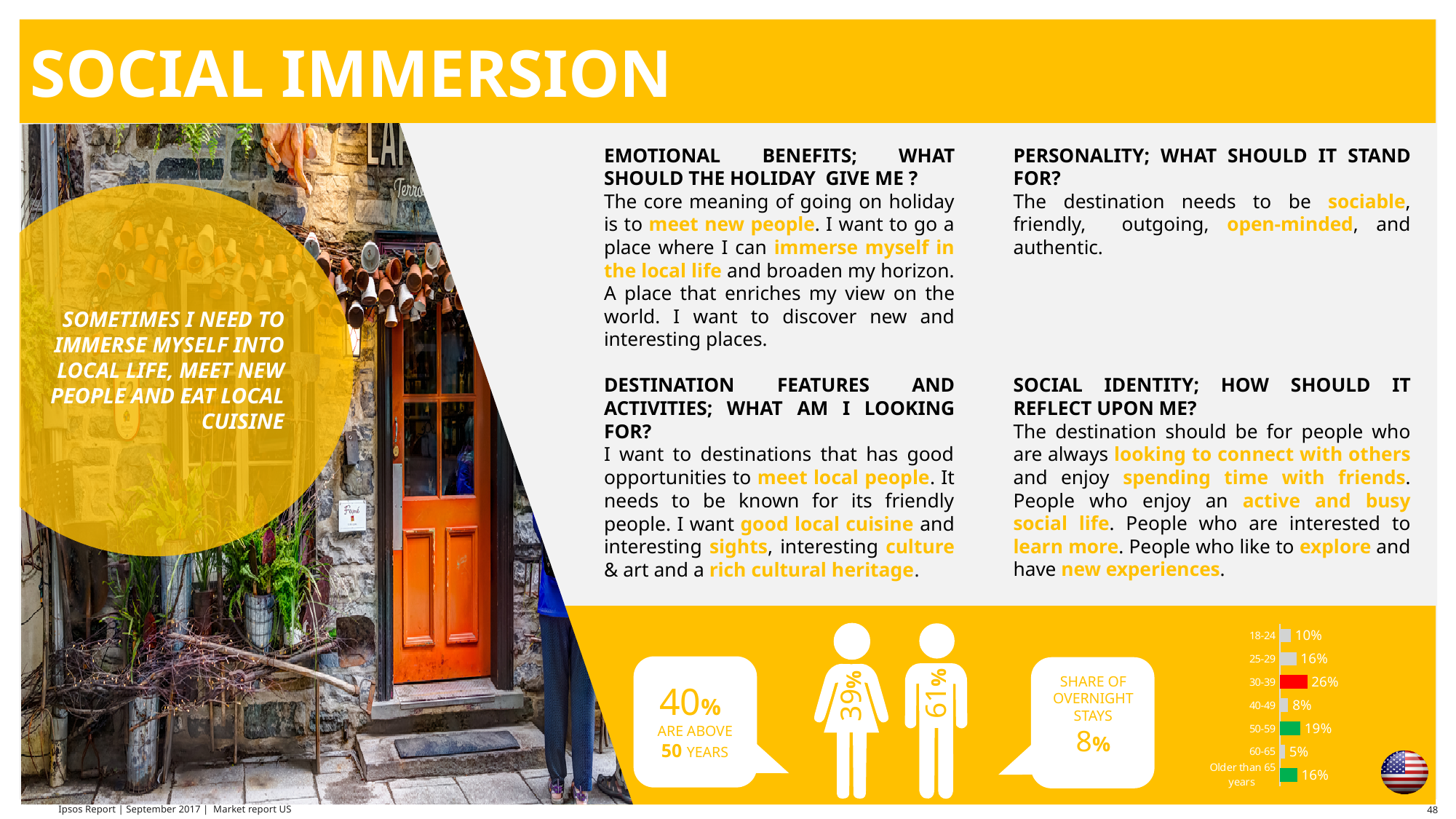
In the age-group bar chart, which age group has the lowest value? 60-65 In the age-group bar chart, what is the value for the 18-24 age group? 10% In the age-group bar chart, what colour is the bar for the 30-39 age group? Red In the age-group bar chart, what is the difference between the values for 30-39 and 40-49? 18% In the age-group bar chart, what is the difference between the values for 50-59 and 60-65? 14% In the age-group bar chart, which is larger: the value for 25-29 or the value for 50-59? 50-59 In the age-group bar chart, what is the value for the 'Older than 65 years' group? 16% How many age groups are shown in the age-group bar chart? 7 In the age-group bar chart, which age group has the highest value? 30-39 What type of chart is used to show the age-group breakdown? Bar chart In the age-group bar chart, what is the value for the 30-39 age group? 26% In the age-group bar chart, what is the value for the 50-59 age group? 19%